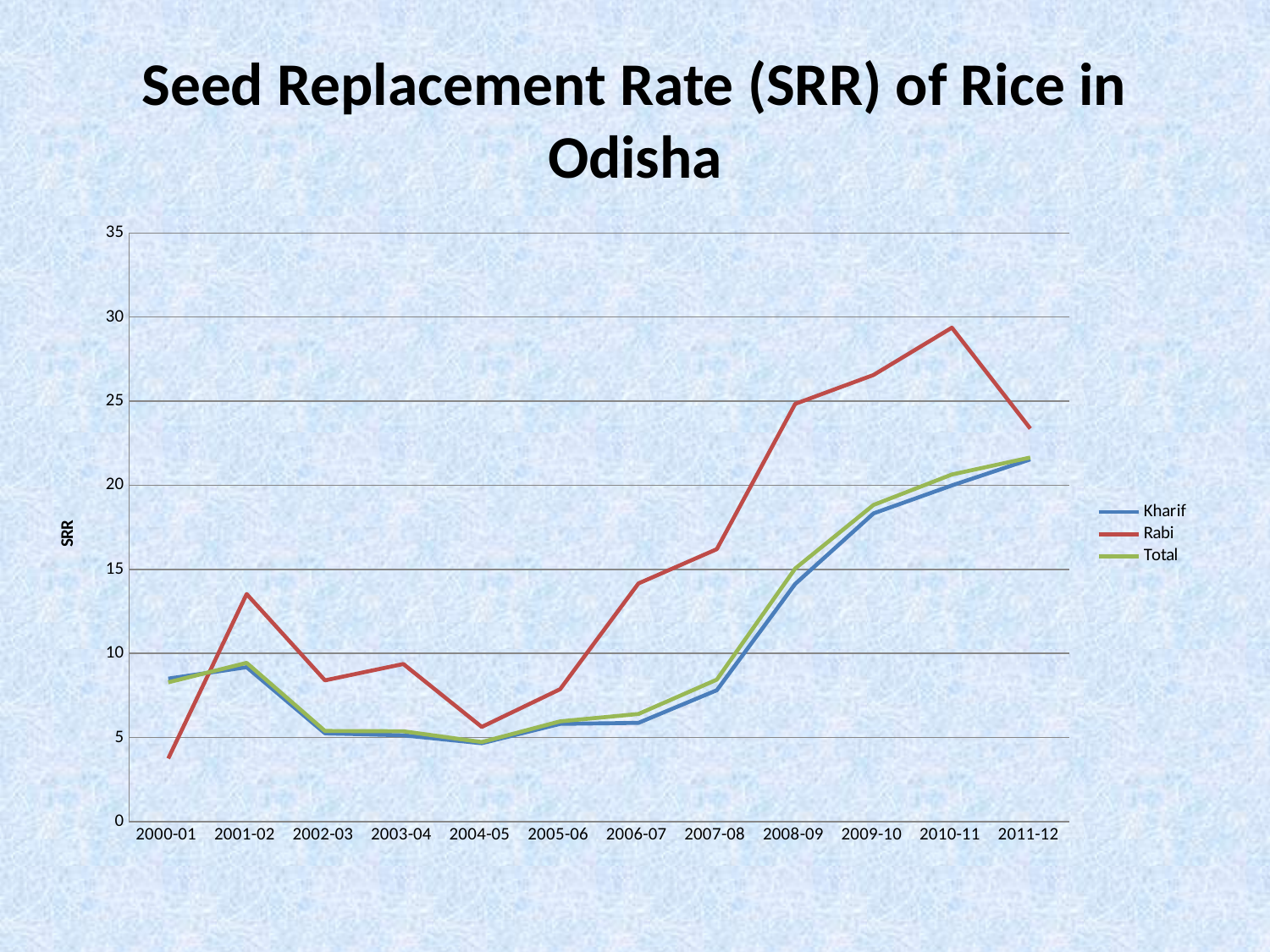
In which year does the Rabi series reach its highest value? 2010-11 In which year is the Rabi series at its lowest value? 2000-01 Is the Rabi value for 2010-11 greater or less than 25? greater What kind of chart is shown on the slide? line chart What is the label on the y axis? SRR Is the Kharif value for 2011-12 greater or less than 20? greater Which series has the larger value in 2010-11, Kharif or Rabi? Rabi How many series does the legend list? 3 Is the Rabi value for 2000-01 greater or less than 5? less Does the Rabi series rise or fall from 2008-09 to 2010-11? rise How many years are plotted along the x axis? 12